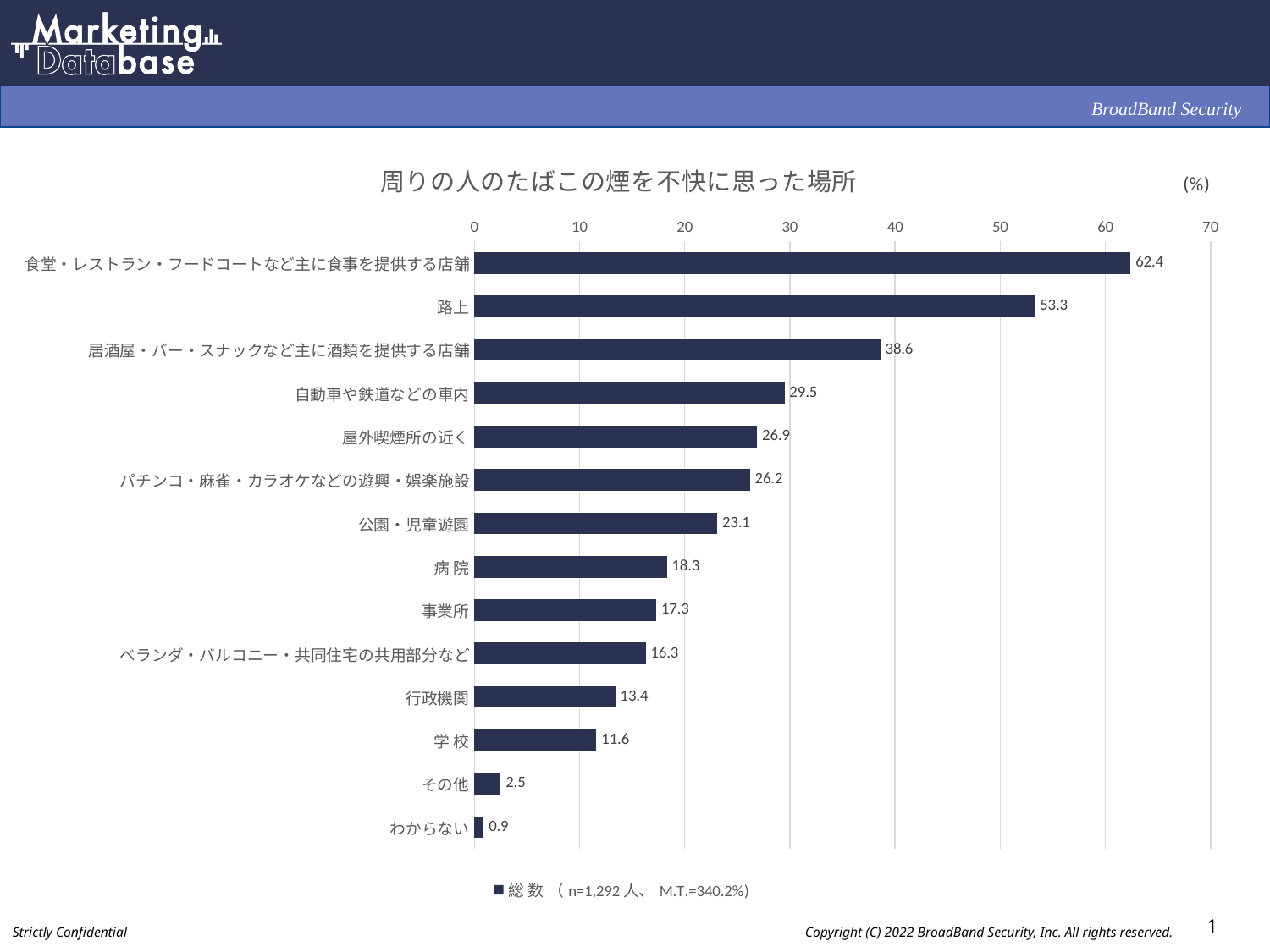
Which category has the highest value? 食堂・レストラン・フードコートなど主に食事を提供する店舗 Is the value for 居酒屋・バー・スナックなど主に酒類を提供する店舗 greater or less than 40? less What is the value for 公園・児童遊園? 23.1 What is the value for 学校? 11.6 What kind of chart is shown on the slide? bar chart What is the value for 路上? 53.3 What is the title of the chart? 周りの人のたばこの煙を不快に思った場所 Which category has the lowest value? わからない How many series does the legend list? 1 What is the difference between the values for 食堂・レストラン・フードコートなど主に食事を提供する店舗 and 路上? 9.1 Which is larger, the value for 病院 or the value for 事業所? 病院 How many categories are shown in the chart? 14